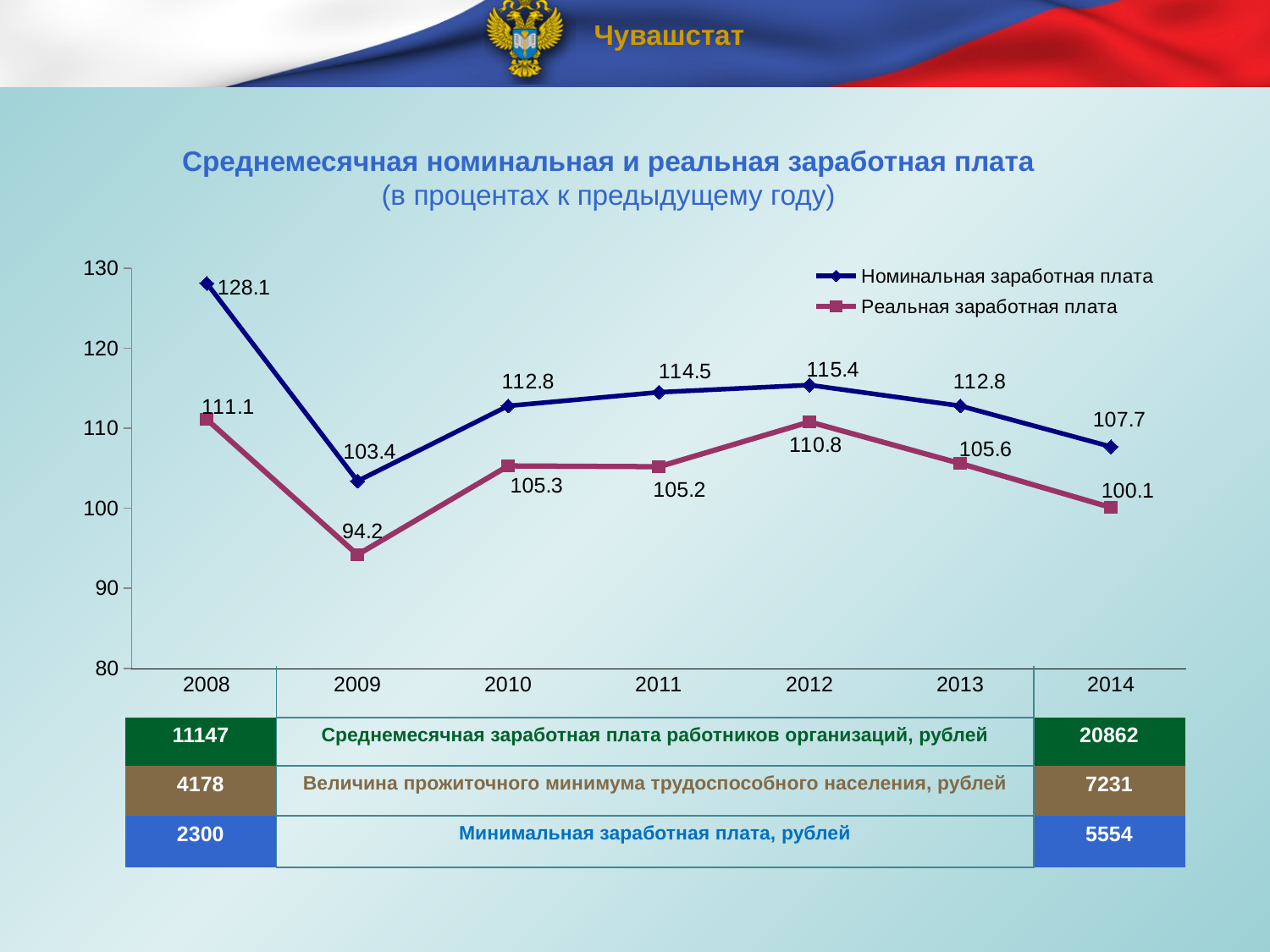
How many years are plotted along the x axis? 7 How many series does the legend list? 2 What colour is the line for Реальная заработная плата? purple/magenta Does Номинальная заработная плата rise or fall from 2012 to 2014? fall What is the value of Номинальная заработная плата in 2008? 128.1 What is the value of Реальная заработная плата in 2009? 94.2 Which is larger in 2013: Номинальная заработная плата or Реальная заработная плата? Номинальная заработная плата What is the difference between Номинальная заработная плата and Реальная заработная плата in 2012? 4.6 In which year is Реальная заработная плата lowest? 2009 What type of chart is shown on the slide? line chart In which year is Номинальная заработная плата highest? 2008 What is the value of Реальная заработная плата in 2014? 100.1